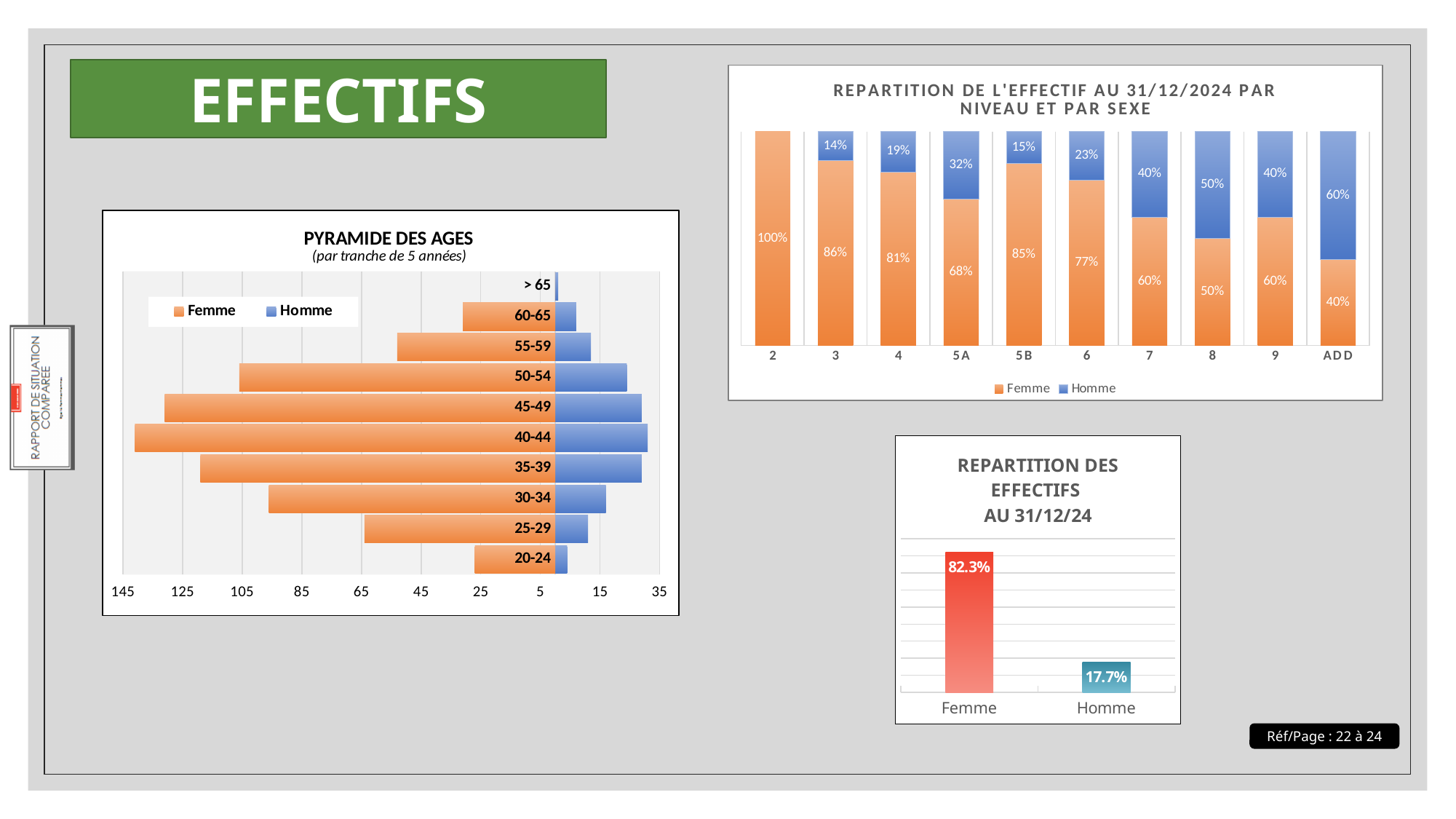
In the 'PYRAMIDE DES AGES' chart, how many age groups are shown? 10 In the 'REPARTITION DE L'EFFECTIF AU 31/12/2024 PAR NIVEAU ET PAR SEXE' chart, which level has the highest Femme share? 2 In the 'REPARTITION DE L'EFFECTIF AU 31/12/2024 PAR NIVEAU ET PAR SEXE' chart, how many levels are shown on the x axis? 10 In the 'REPARTITION DES EFFECTIFS AU 31/12/24' chart, what is the difference between the Femme and Homme values? 64.6 percentage points In the 'REPARTITION DE L'EFFECTIF AU 31/12/2024 PAR NIVEAU ET PAR SEXE' chart, what is the Homme share at level ADD? 60% In the 'REPARTITION DES EFFECTIFS AU 31/12/24' chart, what is the value for Femme? 82.3% In the 'REPARTITION DE L'EFFECTIF AU 31/12/2024 PAR NIVEAU ET PAR SEXE' chart, which level has the highest Homme share? ADD What kind of chart is the 'REPARTITION DES EFFECTIFS AU 31/12/24' chart? Bar chart In the 'PYRAMIDE DES AGES' chart, is the Femme value for 30-34 greater or less than 85? greater In the 'REPARTITION DE L'EFFECTIF AU 31/12/2024 PAR NIVEAU ET PAR SEXE' chart, how many series does the legend list? 2 In the 'REPARTITION DE L'EFFECTIF AU 31/12/2024 PAR NIVEAU ET PAR SEXE' chart, what is the Femme share at level 5A? 68% In the 'PYRAMIDE DES AGES' chart, which age group has the longest Femme bar? 40-44